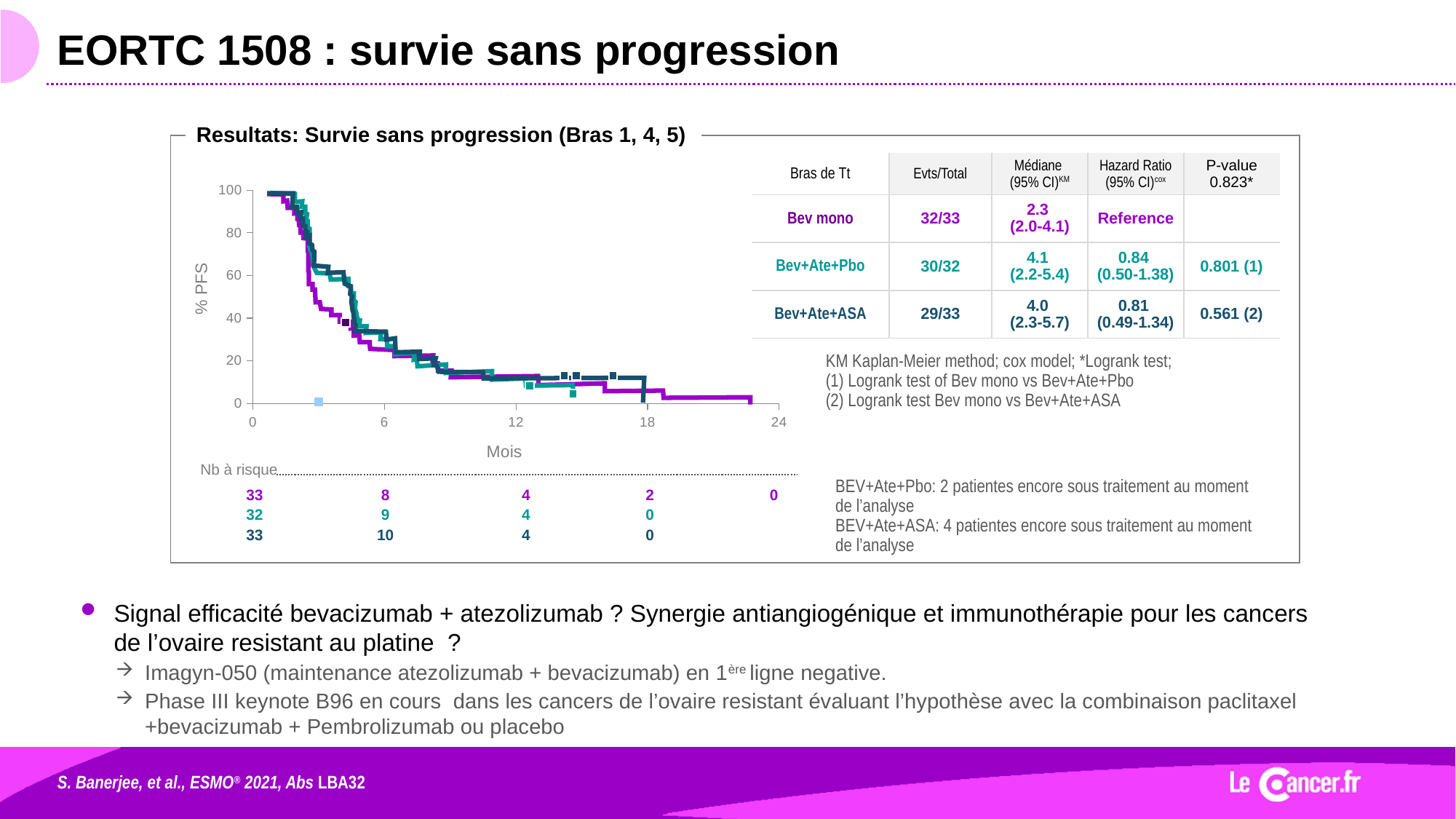
In the 'Nb à risque' row, how many Bev mono patients are at risk at 6 months? 8 What is the label of the y axis of the survival chart? % PFS What is the hazard ratio reported for the Bev+Ate+Pbo arm? 0.84 Do the survival curves rise or fall as months increase along the x axis? fall How many treatment arms are plotted on the survival chart? 3 What is the median PFS (months) reported for the Bev mono arm? 2.3 In the 'Nb à risque' row, how many Bev+Ate+ASA patients are at risk at 6 months? 10 What is the label of the x axis of the survival chart? Mois Which arm has the highest number of patients at risk at 6 months? Bev+Ate+ASA What kind of chart is shown under 'Resultats: Survie sans progression (Bras 1, 4, 5)'? line chart What is the difference between the number at risk at 6 months for Bev+Ate+ASA and for Bev mono? 2 Is the % PFS of the Bev mono curve at 6 months greater or less than 40? less